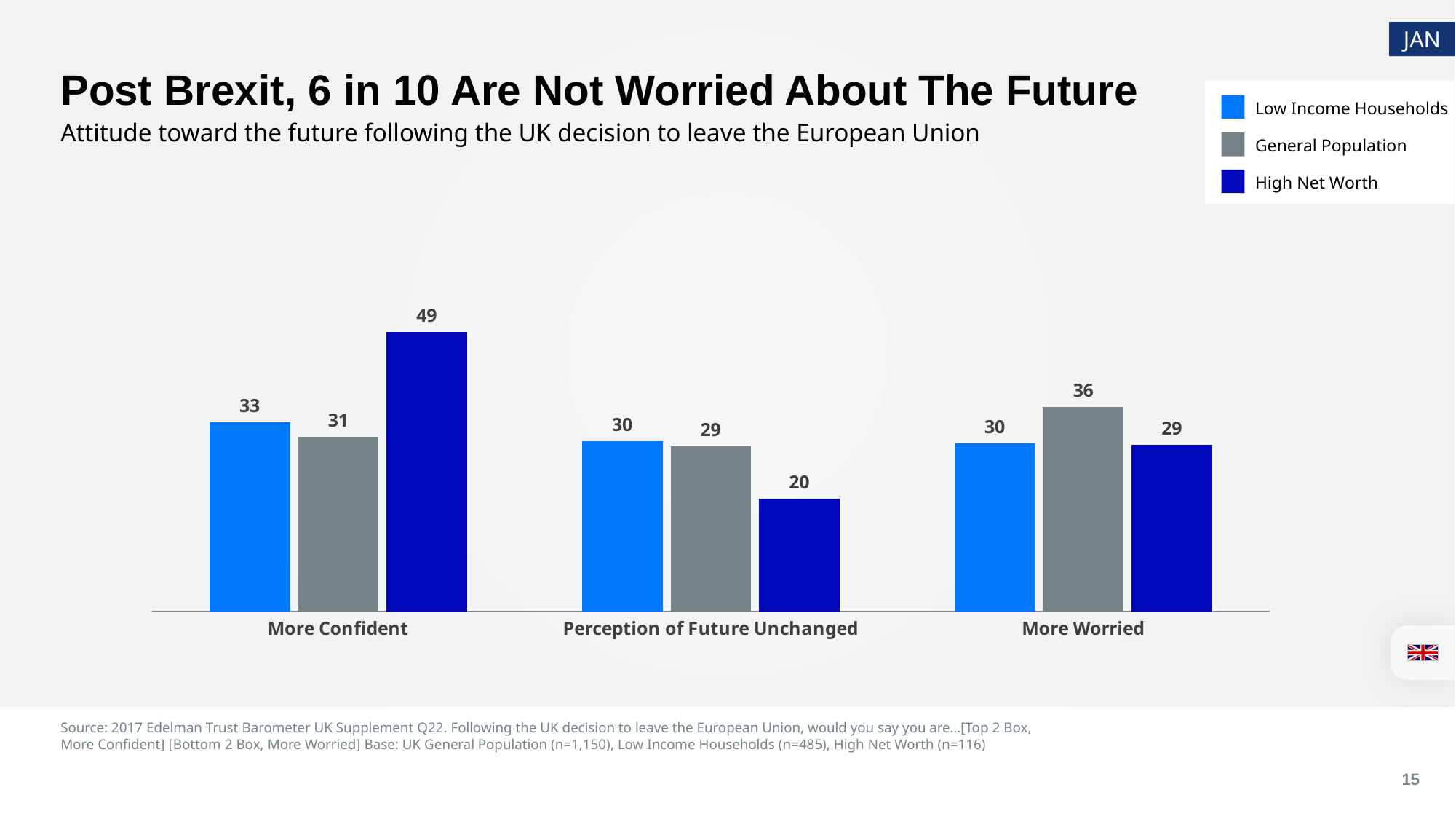
Which is larger: the General Population value for More Worried or the General Population value for More Confident? More Worried What is the value for Low Income Households in the Perception of Future Unchanged category? 30 How many categories are shown on the x axis? 3 What is the value for General Population in the More Worried category? 36 What kind of chart is shown on the slide? Bar chart How many series does the legend list? 3 What is the difference between the General Population and High Net Worth values in the Perception of Future Unchanged category? 9 Which series has the highest value in the More Confident category? High Net Worth Which series is shown in grey in the legend? General Population Which series has the lowest value in the Perception of Future Unchanged category? High Net Worth What is the value for High Net Worth in the More Confident category? 49 What is the difference between the High Net Worth value for More Confident and the High Net Worth value for More Worried? 20